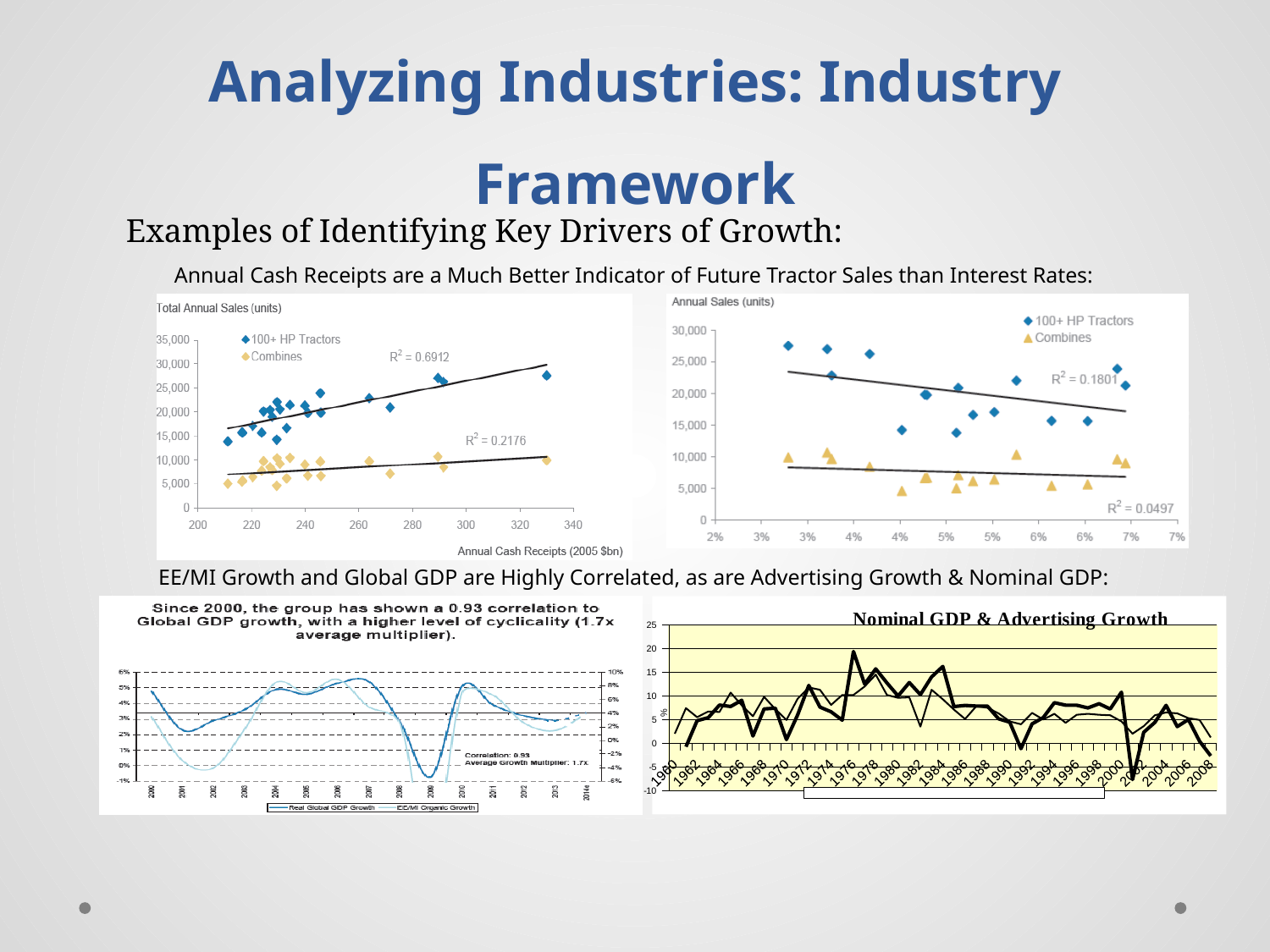
How many series does the legend of the bottom-left chart (Real Global GDP Growth and EE/MI Organic Growth) list? 2 In the top-left chart (Total Annual Sales vs Annual Cash Receipts), what is the R² value shown for the Combines trend line? R² = 0.2176 How many series does the legend of the top-left chart (Total Annual Sales vs Annual Cash Receipts) list? 2 In the top-left chart (Total Annual Sales vs Annual Cash Receipts), what is the R² value shown for the 100+ HP Tractors trend line? R² = 0.6912 In the top-left chart (Total Annual Sales vs Annual Cash Receipts), does the 100+ HP Tractors trend line rise or fall as Annual Cash Receipts increase? Rise In the top-right chart (Annual Sales vs interest rate), is the highest 100+ HP Tractors point greater or less than 25,000 units? greater In the top-right chart (Annual Sales vs interest rate), what is the R² value shown for the 100+ HP Tractors trend line? R² = 0.1801 What kind of chart is the top-left chart plotting Total Annual Sales against Annual Cash Receipts? Scatter chart In the top-right chart (Annual Sales vs interest rate), does the 100+ HP Tractors trend line rise or fall as the interest rate increases? Fall What kind of chart is the bottom-right chart titled 'Nominal GDP & Advertising Growth'? Line chart In the top-right chart (Annual Sales vs interest rate), what is the R² value shown for the Combines trend line? R² = 0.0497 In the bottom-left chart, what correlation value is printed between Real Global GDP Growth and EE/MI Organic Growth? 0.93